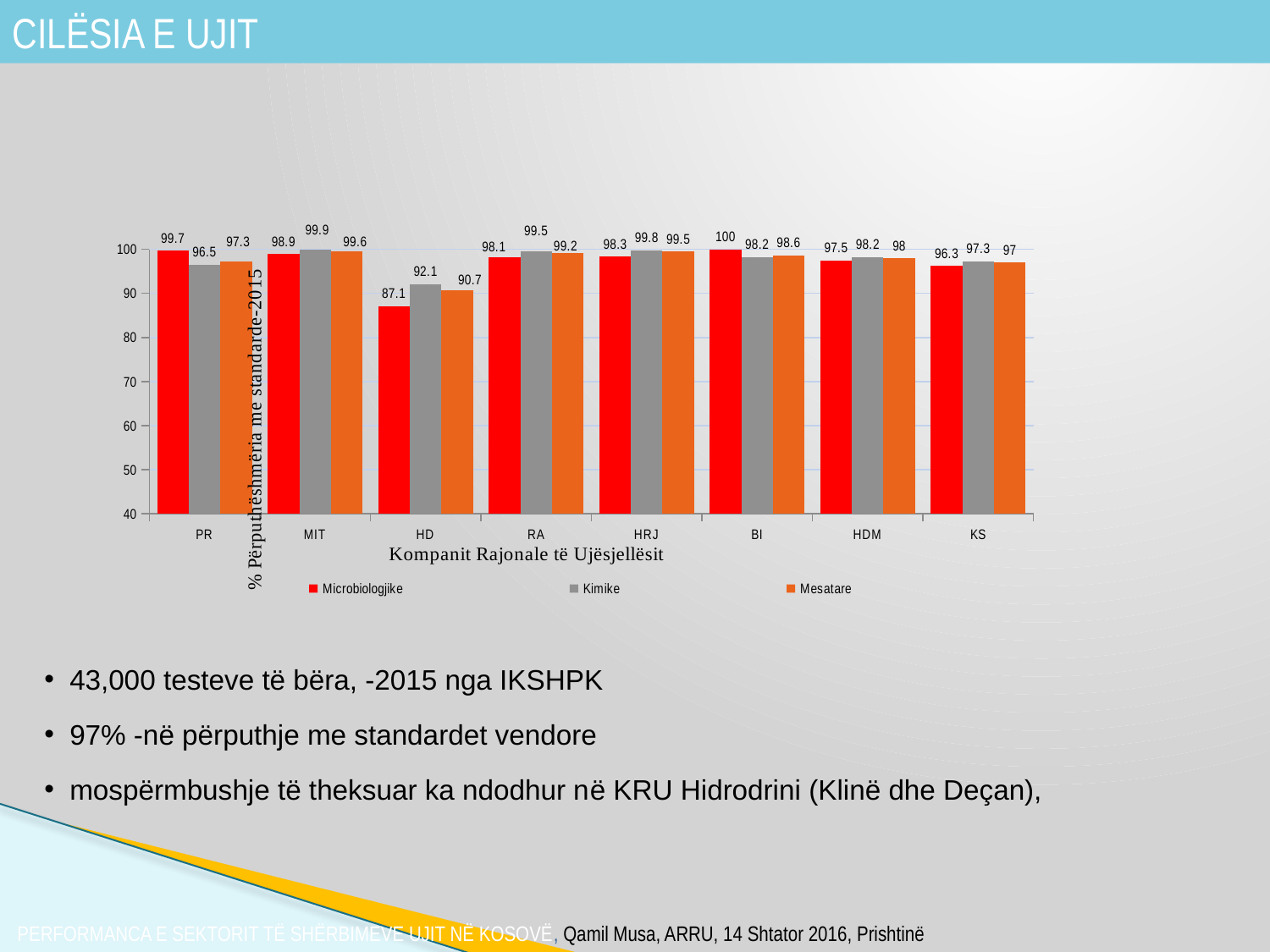
Which company has the highest Microbiologjike value? BI Which company has the lowest Mesatare value? HD What kind of chart is shown on the slide? Bar chart What is the x-axis title of the chart? Kompanit Rajonale të Ujësjellësit Is the Mesatare value for HD greater or less than 90? greater How many regional water companies are shown on the x axis? 8 Which is larger for PR: the Microbiologjike value or the Kimike value? Microbiologjike What is the difference between the Kimike and Microbiologjike values for HD? 5 How many series does the legend list? 3 What is the Kimike value for MIT? 99.9 What is the Mesatare value for KS? 97 What is the Microbiologjike value for HD? 87.1